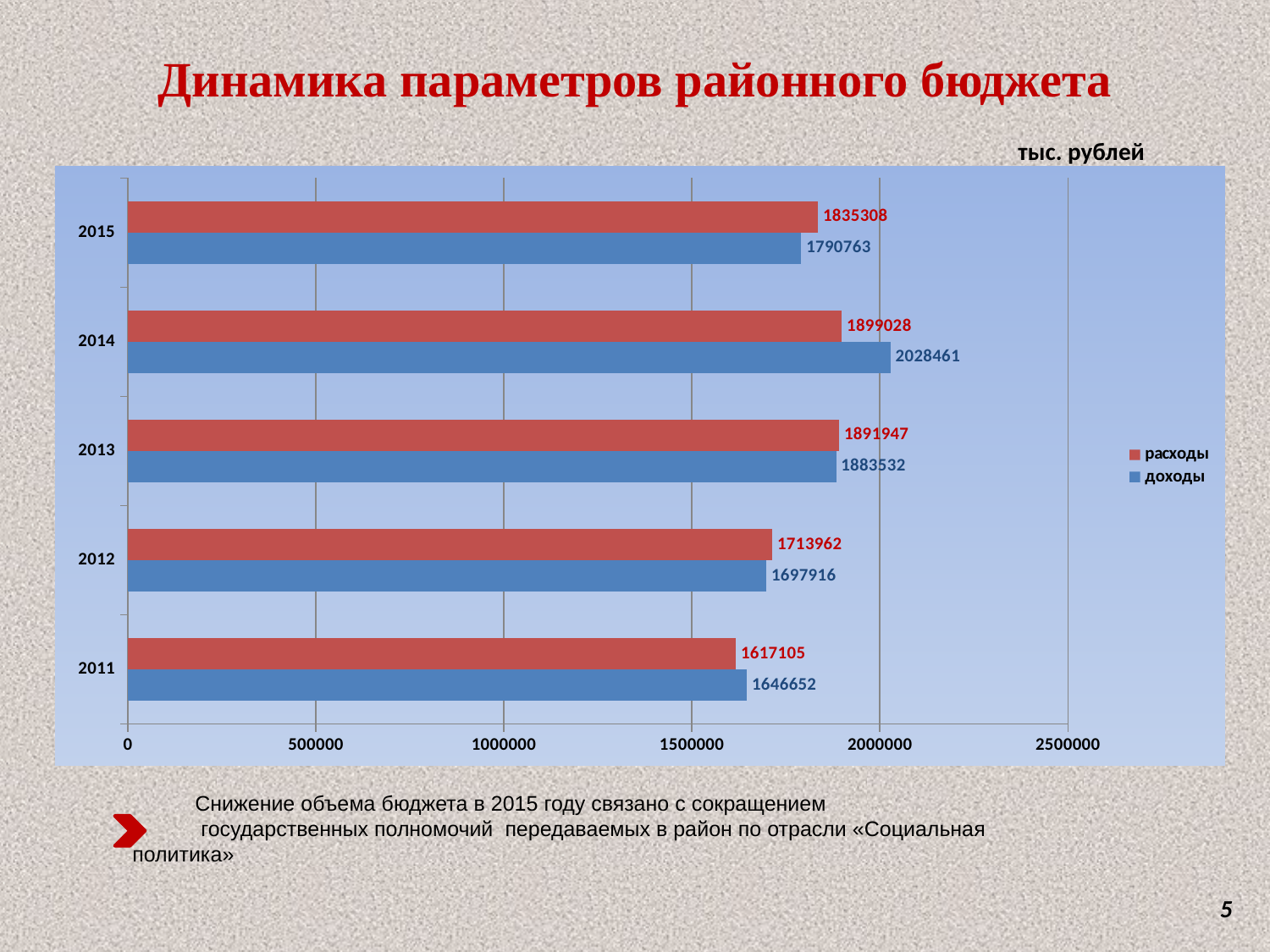
What is the difference between доходы and расходы in 2014? 129433 What is the value of расходы for 2015? 1835308 In which year is расходы the lowest? 2011 Which is larger in 2015, расходы or доходы? расходы How many series does the legend list? 2 What is the value of доходы for 2011? 1646652 What is the value of расходы for 2012? 1713962 What kind of chart is shown on the slide? bar chart Is the value of доходы for 2014 greater or less than 2000000? greater What is the value of доходы for 2014? 2028461 How many years are shown on the chart? 5 In which year is доходы the highest? 2014